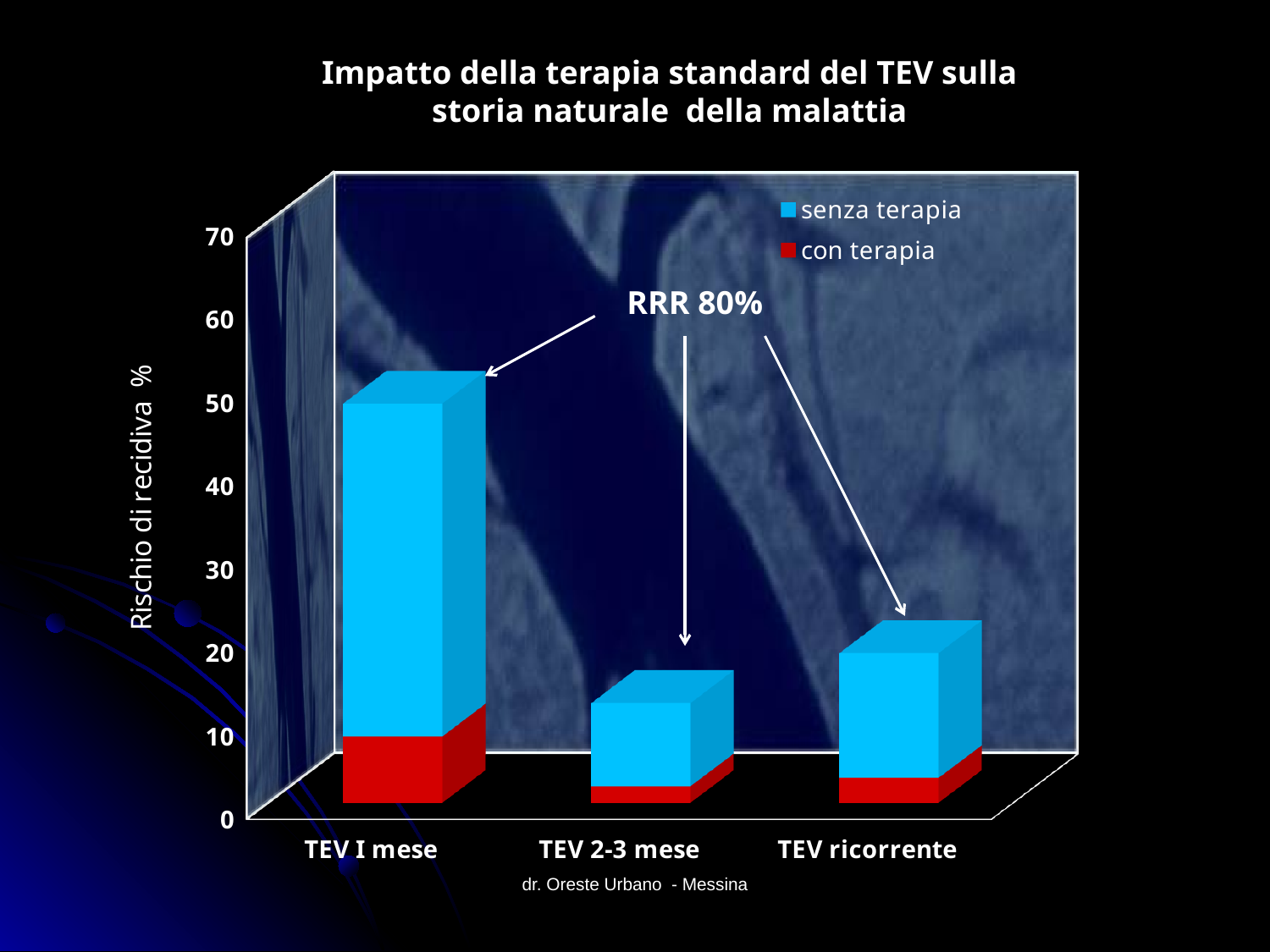
What is the label on the chart's vertical axis? Rischio di recidiva % Which category has the highest total bar in the chart? TEV I mese What kind of chart is shown on the slide? bar chart How many categories are shown on the x axis of the chart? 3 Which category has the lowest total bar in the chart? TEV 2-3 mese How many series does the chart's legend list? 2 What are the two series named in the chart's legend? senza terapia, con terapia Which has a taller total bar, TEV 2-3 mese or TEV ricorrente? TEV ricorrente Is the total value for TEV ricorrente greater or less than 30? less Which has a taller total bar, TEV I mese or TEV ricorrente? TEV I mese Is the total value for TEV 2-3 mese greater or less than 20? less Is the total value for TEV I mese greater or less than 40? greater